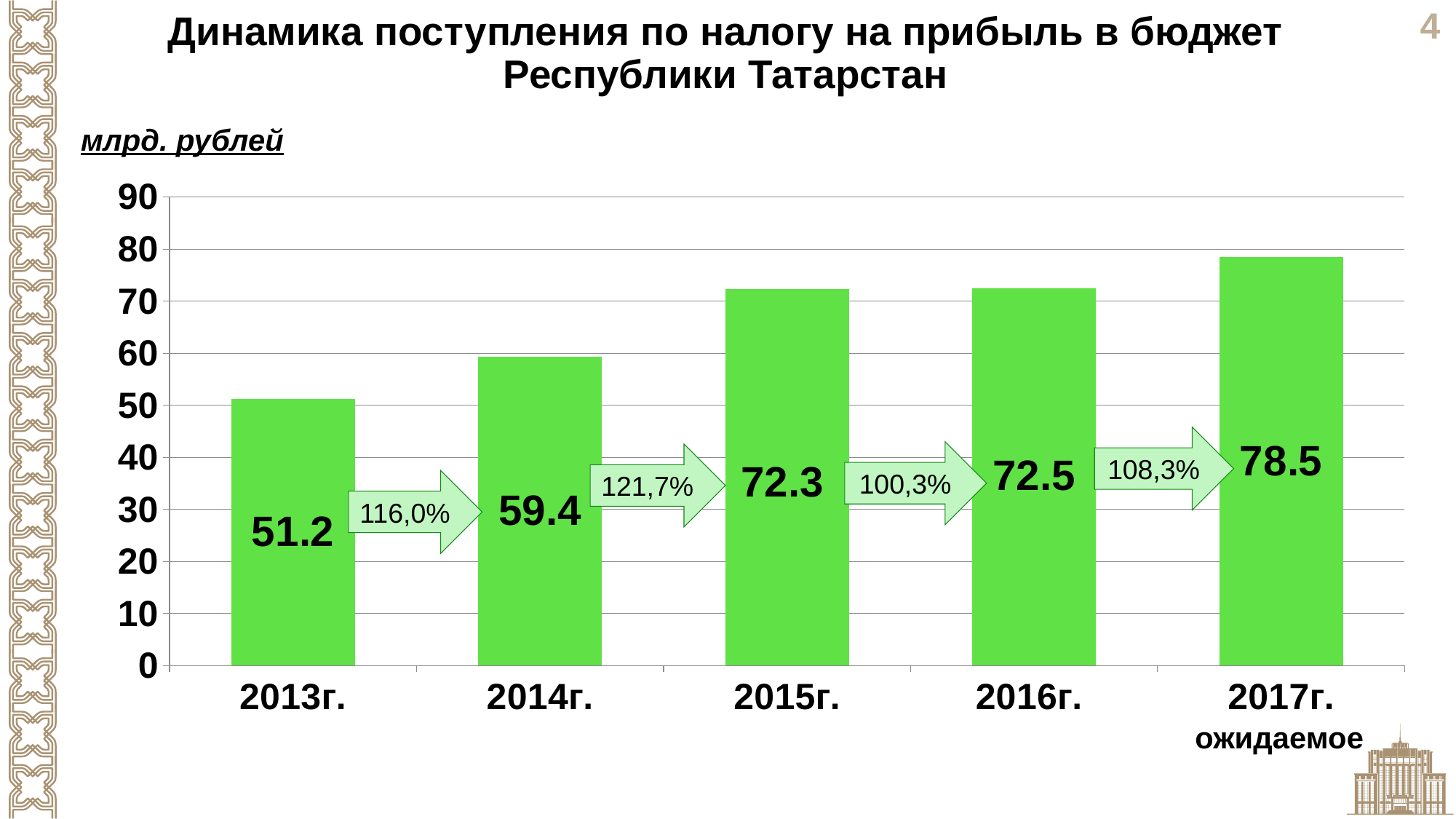
What is the expected value for 2017г.? 78.5 What is the value for 2015г.? 72.3 Is the value for 2016г. greater or less than 70? greater What growth percentage is shown on the arrow between 2014г. and 2015г.? 121,7% What kind of chart is shown on the slide? bar chart Which is larger, the value for 2014г. or the value for 2015г.? 2015г. What is the difference between the values for 2017г. and 2016г.? 6 What is the difference between the values for 2014г. and 2013г.? 8.2 What is the value for 2013г.? 51.2 How many years are shown on the chart? 5 Which year has the lowest value? 2013г. Which year has the highest value? 2017г.